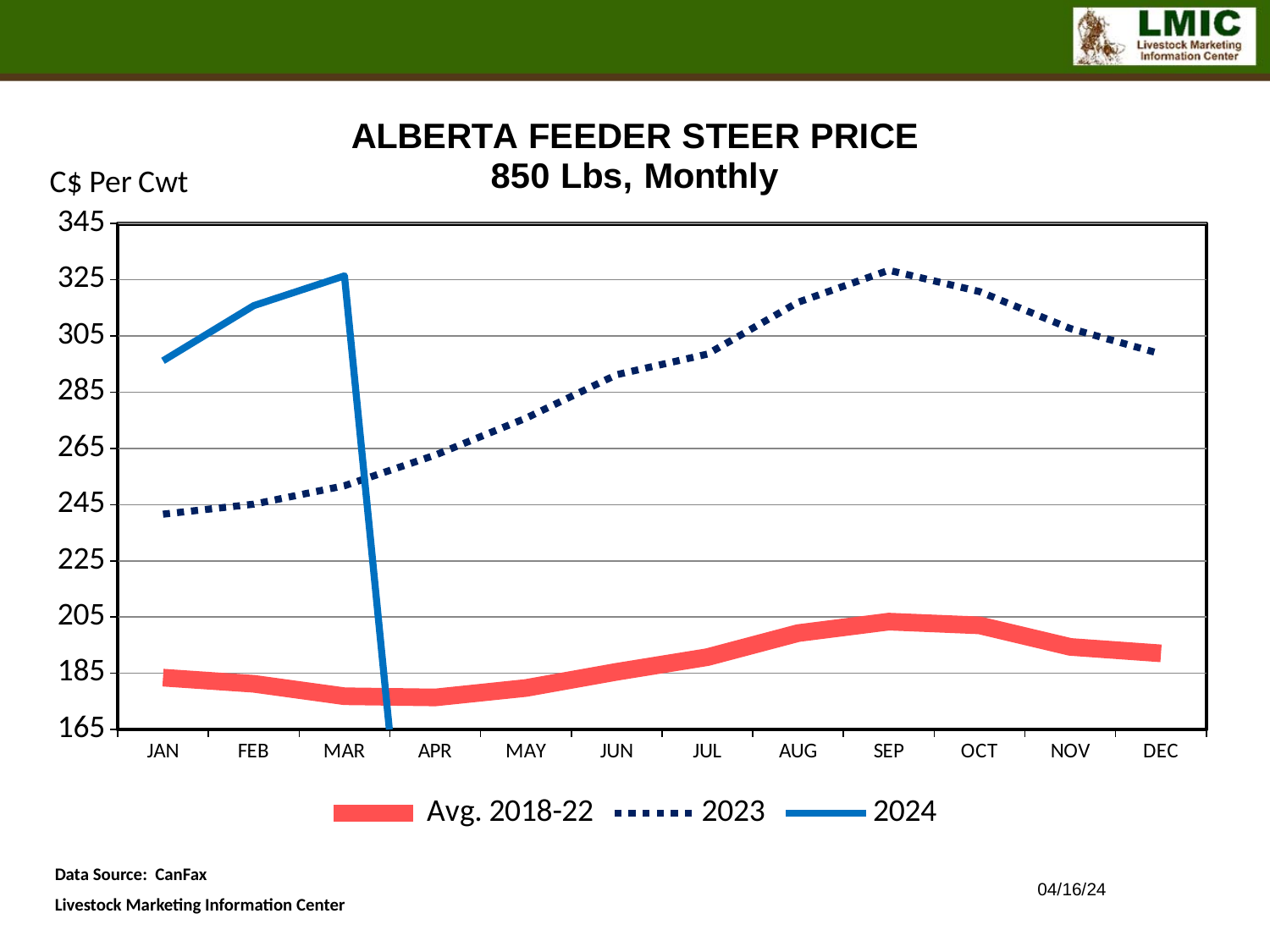
How many months are shown along the x axis? 12 Does the 2024 series rise or fall from JAN to MAR? rise In which month does the 2023 series reach its highest value? SEP Is the 2024 value for JAN greater or less than 285? greater In which month does the Avg. 2018-22 series reach its highest value? SEP How many series does the legend list? 3 Is the 2023 value for JUN greater or less than 285? greater What kind of chart is shown on the slide? line chart In which month is the 2023 series at its lowest value? JAN Is the Avg. 2018-22 value for JAN greater or less than 205? less What unit is shown on the y axis label? C$ Per Cwt Which series has the higher value in JAN, 2023 or 2024? 2024